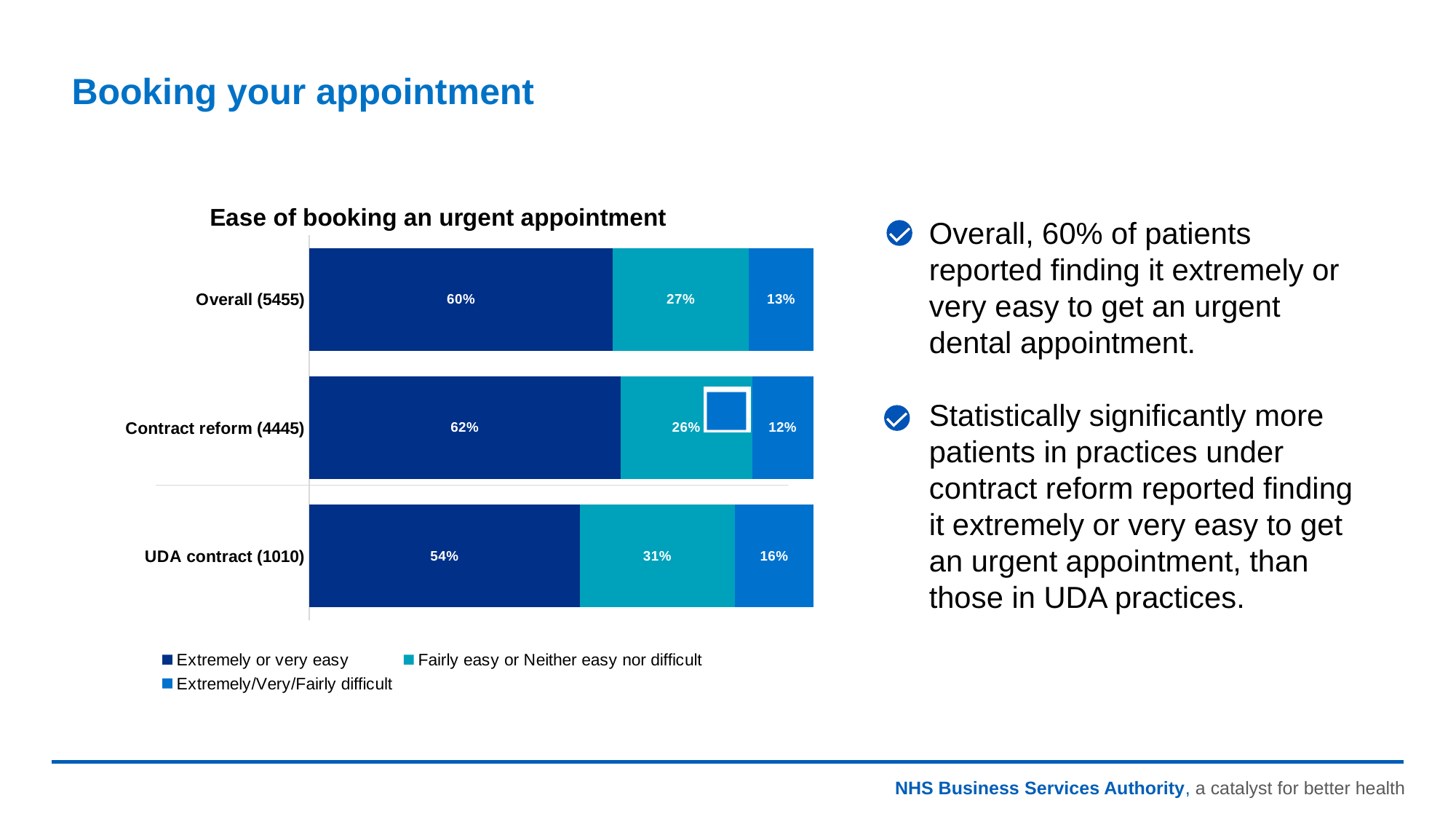
Which has a larger 'Extremely/Very/Fairly difficult' share, Overall (5455) or UDA contract (1010)? UDA contract (1010) What percentage of UDA contract (1010) respondents found it extremely/very/fairly difficult? 16% How many categories (bars) are shown in the chart? 3 What type of chart is shown on the slide? Stacked bar chart What percentage of Overall (5455) respondents found booking an urgent appointment extremely or very easy? 60% What is the difference in the 'Extremely or very easy' percentage between Contract reform (4445) and UDA contract (1010)? 8 percentage points How many series does the legend list? 3 What is the total of the three segments in the UDA contract (1010) bar? 101% What is the title of the chart? Ease of booking an urgent appointment Which category has the highest share of 'Extremely or very easy' responses? Contract reform (4445) Which category has the lowest share of 'Extremely or very easy' responses? UDA contract (1010) What percentage of Contract reform (4445) respondents answered fairly easy or neither easy nor difficult? 26%